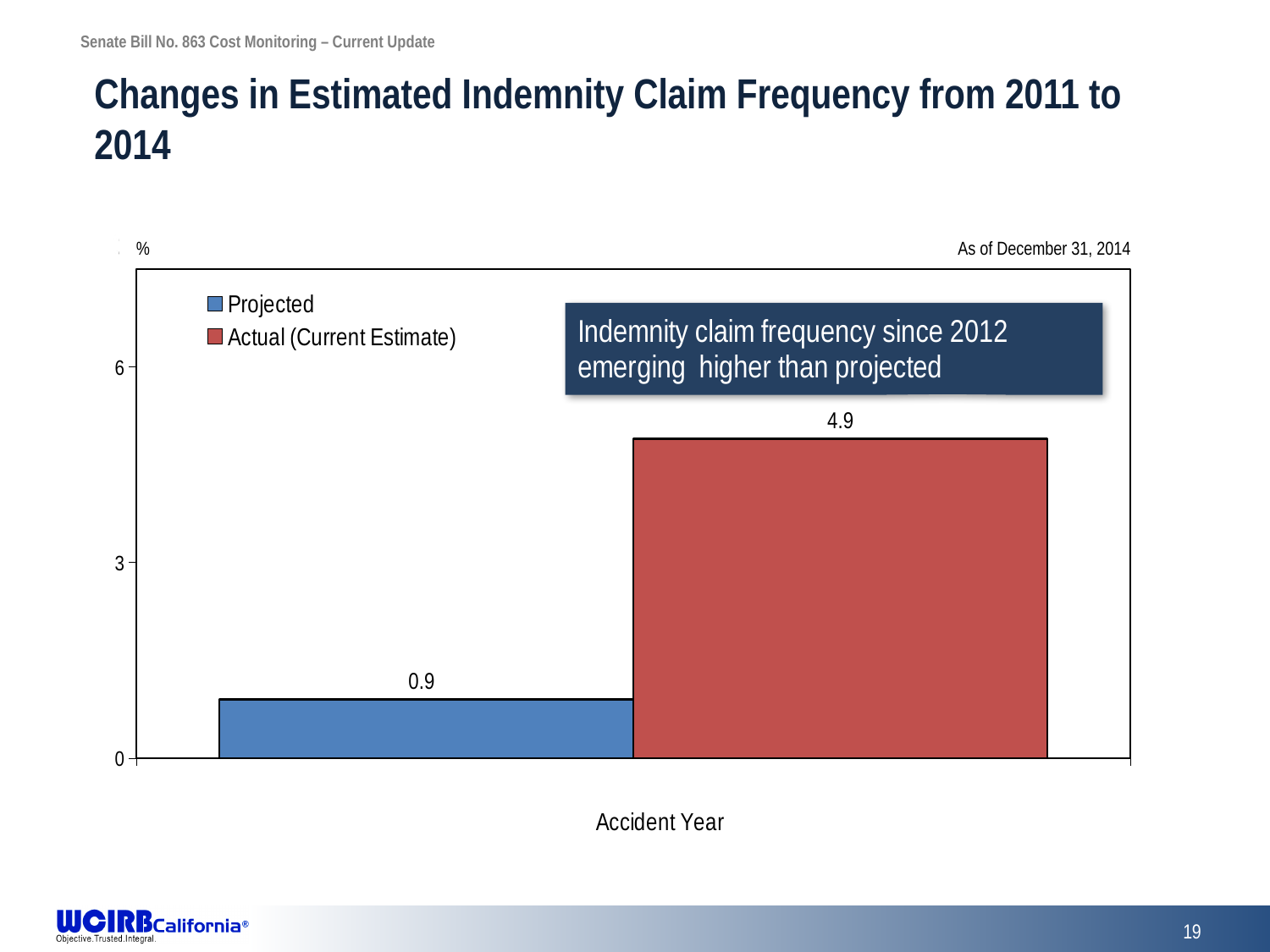
What is the x-axis label of the chart? Accident Year Which series has the higher value, Projected or Actual (Current Estimate)? Actual (Current Estimate) Is the value for Actual (Current Estimate) greater or less than 3? greater What colour is the Actual (Current Estimate) bar? Red Is the value for Projected greater or less than 3? less What is the value of the Projected bar? 0.9 How many series does the legend list? 2 Which bar is the highest on the chart? Actual (Current Estimate) What is the value of the Actual (Current Estimate) bar? 4.9 What kind of chart is shown on the slide? Bar chart What is the difference between the Actual (Current Estimate) value and the Projected value? 4.0 Which bar is the lowest on the chart? Projected